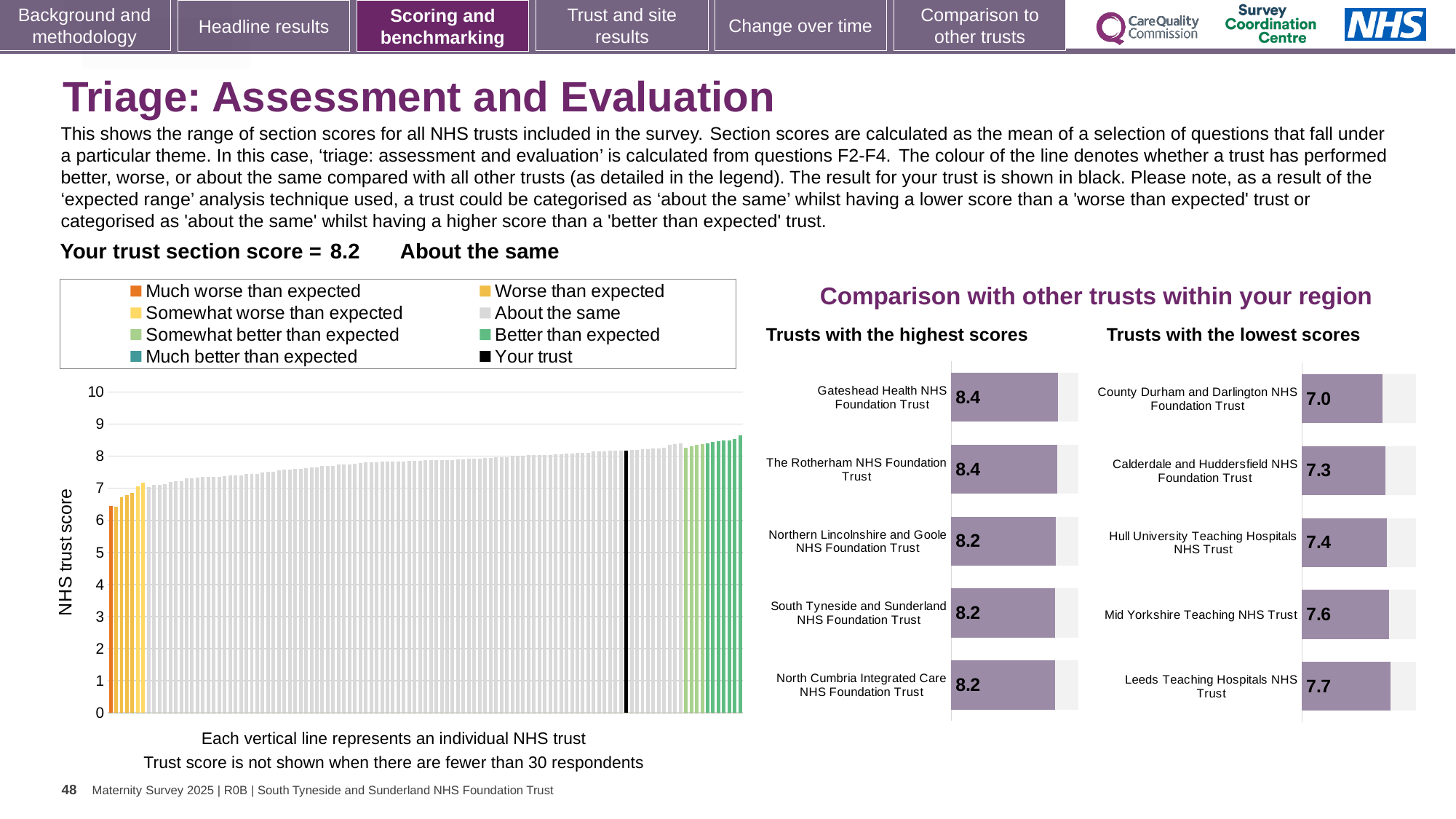
What kind of chart is the large chart on the left with the y axis labelled 'NHS trust score'? bar chart In the 'Trusts with the highest scores' chart, what is the score for Gateshead Health NHS Foundation Trust? 8.4 In the large chart on the left, is the value of the highest (rightmost) bar greater or less than 8? greater In the large chart on the left, is the value of the lowest (leftmost) bar greater or less than 7? less In the 'Trusts with the lowest scores' chart, which trust has the highest score? Leeds Teaching Hospitals NHS Trust In the 'Trusts with the highest scores' chart, what is the difference between the scores of The Rotherham NHS Foundation Trust and North Cumbria Integrated Care NHS Foundation Trust? 0.2 In the 'Trusts with the lowest scores' chart, which trust has the lowest score? County Durham and Darlington NHS Foundation Trust In the 'Trusts with the lowest scores' chart, which has the larger score: Hull University Teaching Hospitals NHS Trust or Calderdale and Huddersfield NHS Foundation Trust? Hull University Teaching Hospitals NHS Trust In the large chart on the left, how many entries does the legend list? 8 In the large chart on the left, do the trust scores rise or fall from left to right? rise In the 'Trusts with the lowest scores' chart, what is the difference between the scores of Leeds Teaching Hospitals NHS Trust and County Durham and Darlington NHS Foundation Trust? 0.7 In the 'Trusts with the highest scores' chart, how many trusts are shown? 5